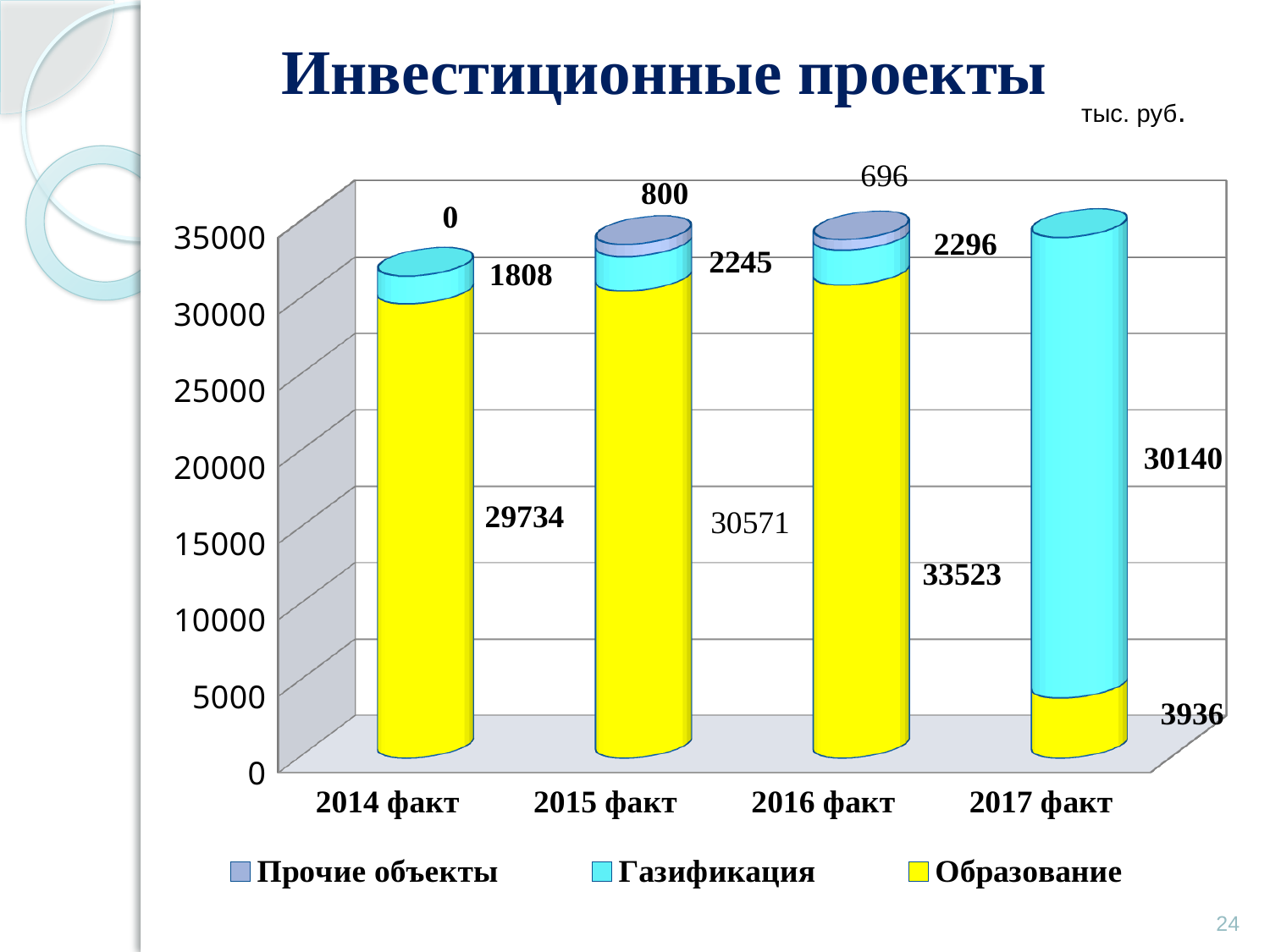
Which is larger: Прочие объекты for 2015 факт or for 2016 факт? 2015 факт What is the value of Газификация for 2017 факт? 30140 What is the value of Газификация for 2016 факт? 2296 How many categories are shown on the x axis? 4 In which year is the Образование value the highest? 2016 факт In which year is the Образование value the lowest? 2017 факт What is the value of Образование for 2014 факт? 29734 What is the value of Прочие объекты for 2015 факт? 800 How many series does the legend list? 3 What is the total of the stacked bar for 2015 факт? 33616 What kind of chart is shown on the slide? stacked bar chart